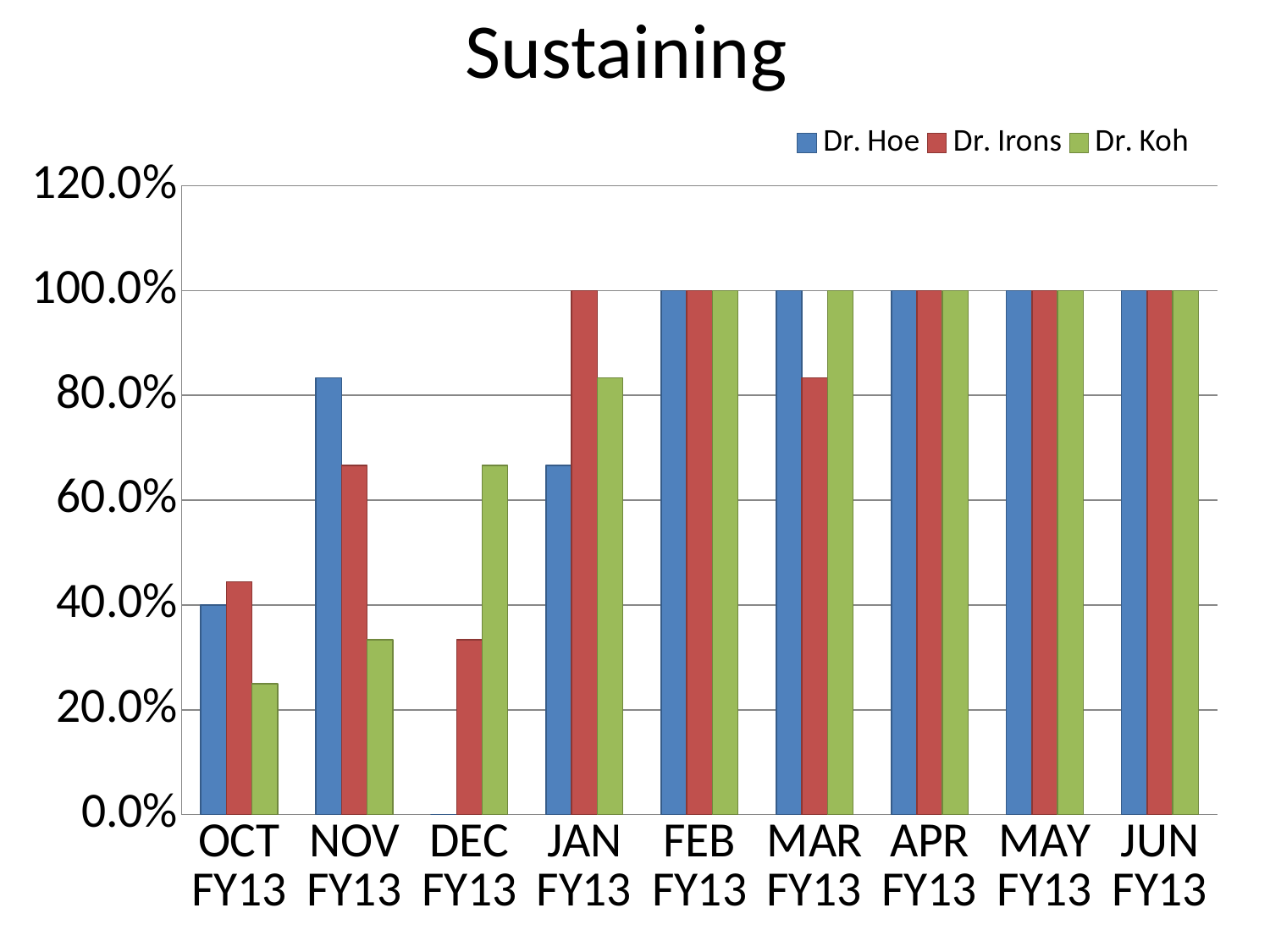
Is the value for Dr. Irons in DEC FY13 greater or less than 40.0%? less Which doctor has the lowest value in OCT FY13? Dr. Koh In NOV FY13, which is larger: the value for Dr. Irons or the value for Dr. Koh? Dr. Irons What is the value for Dr. Irons in JAN FY13? 100.0% What is the title of the chart? Sustaining What kind of chart is shown on the slide? bar chart Which doctor has the highest value in OCT FY13? Dr. Irons How many series does the legend list? 3 Is the value for Dr. Hoe in NOV FY13 greater or less than 80.0%? greater What is the value for Dr. Hoe in OCT FY13? 40.0% What is the value for Dr. Koh in MAR FY13? 100.0% How many months are shown on the x axis? 9